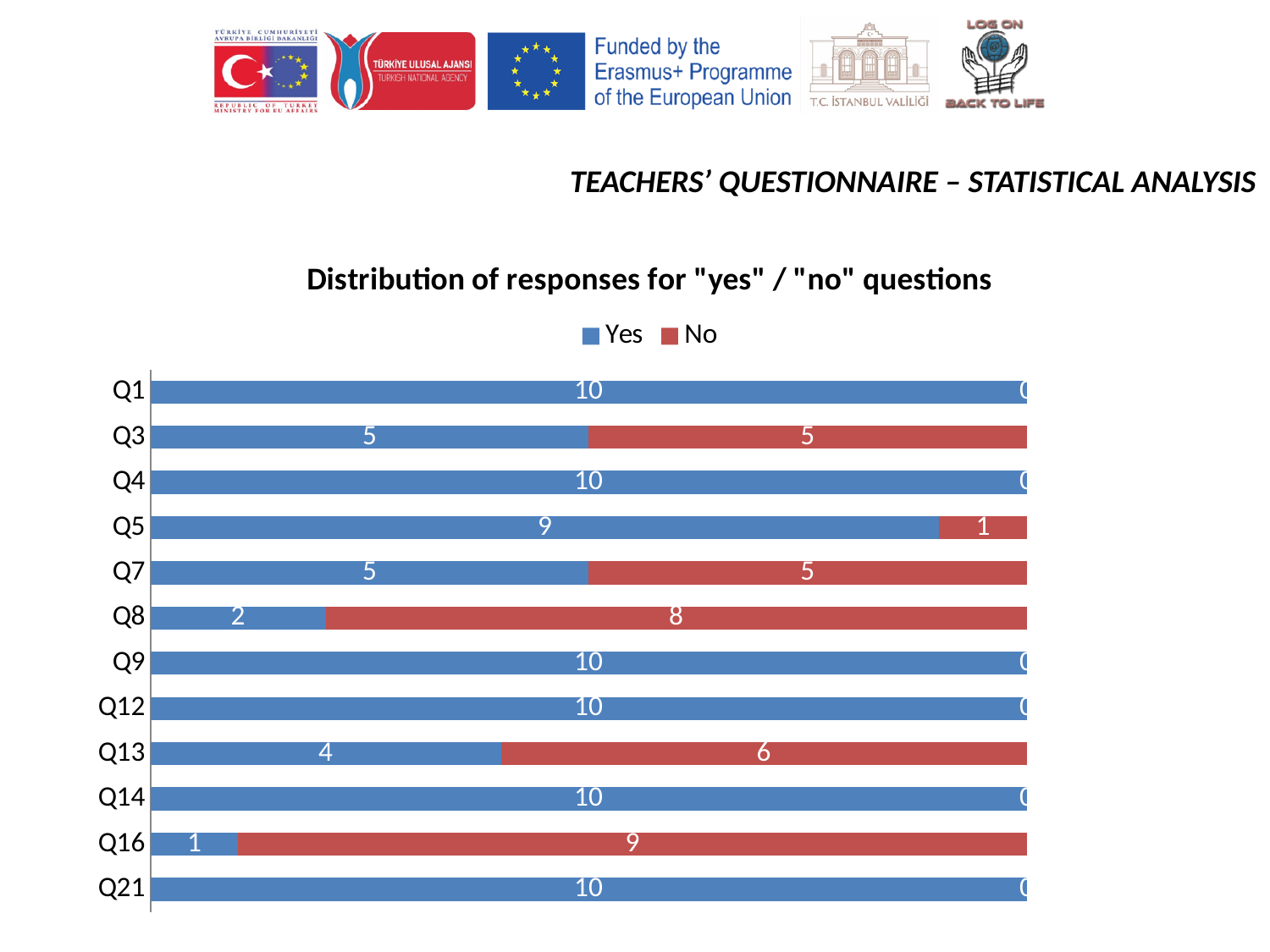
What is the total number of responses for Q7 (Yes plus No)? 10 How many "Yes" responses are shown for Q8? 2 How many questions (categories) are shown on the chart? 12 How many "Yes" responses are shown for Q5? 9 What kind of chart is shown on the slide? Stacked bar chart What is the title of the chart? Distribution of responses for "yes" / "no" questions How many series does the legend list? 2 Which is larger: the "Yes" responses for Q13 or the "Yes" responses for Q3? Q3 Which question has the lowest number of "Yes" responses? Q16 How many "No" responses are shown for Q13? 6 What is the difference between the "No" responses for Q8 and the "No" responses for Q5? 7 Which question has the highest number of "No" responses? Q16